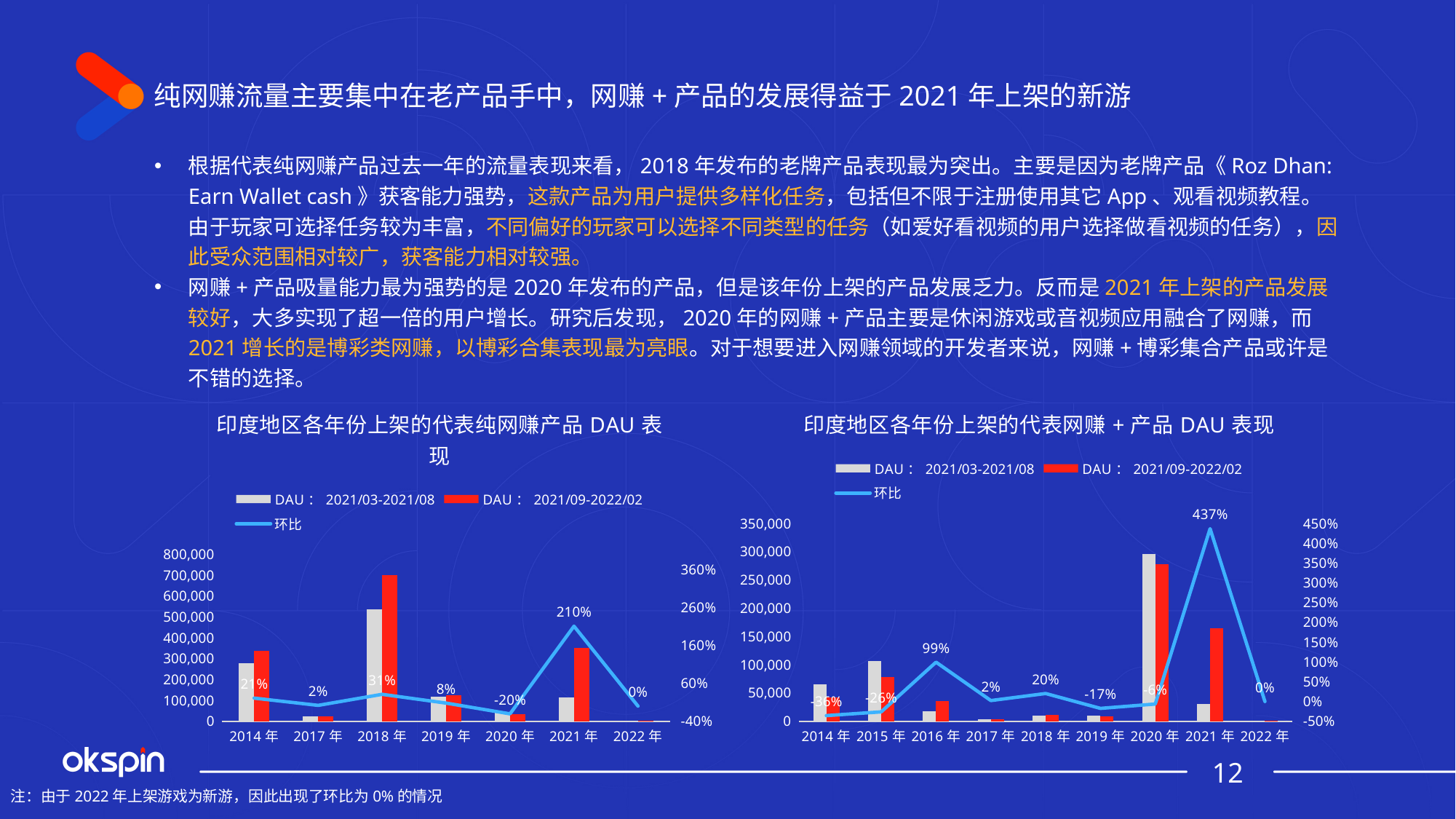
In the left chart (印度地区各年份上架的代表纯网赚产品 DAU 表现), is the DAU 2021/09-2022/02 value for 2018 年 greater or less than 600,000? greater In the right chart (印度地区各年份上架的代表网赚 + 产品 DAU 表现), which year has the highest 环比 value? 2021 年 In the right chart (印度地区各年份上架的代表网赚 + 产品 DAU 表现), what is the 环比 value for 2016 年? 99% How many years are shown on the x axis of the right chart (印度地区各年份上架的代表网赚 + 产品 DAU 表现)? 9 In the left chart (印度地区各年份上架的代表纯网赚产品 DAU 表现), what is the 环比 value for 2021 年? 210% What kind of chart is the left chart (印度地区各年份上架的代表纯网赚产品 DAU 表现)? Combined bar and line chart In the right chart (印度地区各年份上架的代表网赚 + 产品 DAU 表现), which year has the lowest 环比 value? 2014 年 In the left chart (印度地区各年份上架的代表纯网赚产品 DAU 表现), what is the 环比 value for 2020 年? -20% In the right chart (印度地区各年份上架的代表网赚 + 产品 DAU 表现), is the DAU 2021/03-2021/08 value for 2020 年 greater or less than 250,000? greater In the right chart (印度地区各年份上架的代表网赚 + 产品 DAU 表现), which is larger for 2021 年: DAU 2021/03-2021/08 or DAU 2021/09-2022/02? DAU 2021/09-2022/02 In the left chart (印度地区各年份上架的代表纯网赚产品 DAU 表现), what is the difference between the 环比 values for 2021 年 and 2018 年? 179% How many series does the legend of the left chart (印度地区各年份上架的代表纯网赚产品 DAU 表现) list? 3